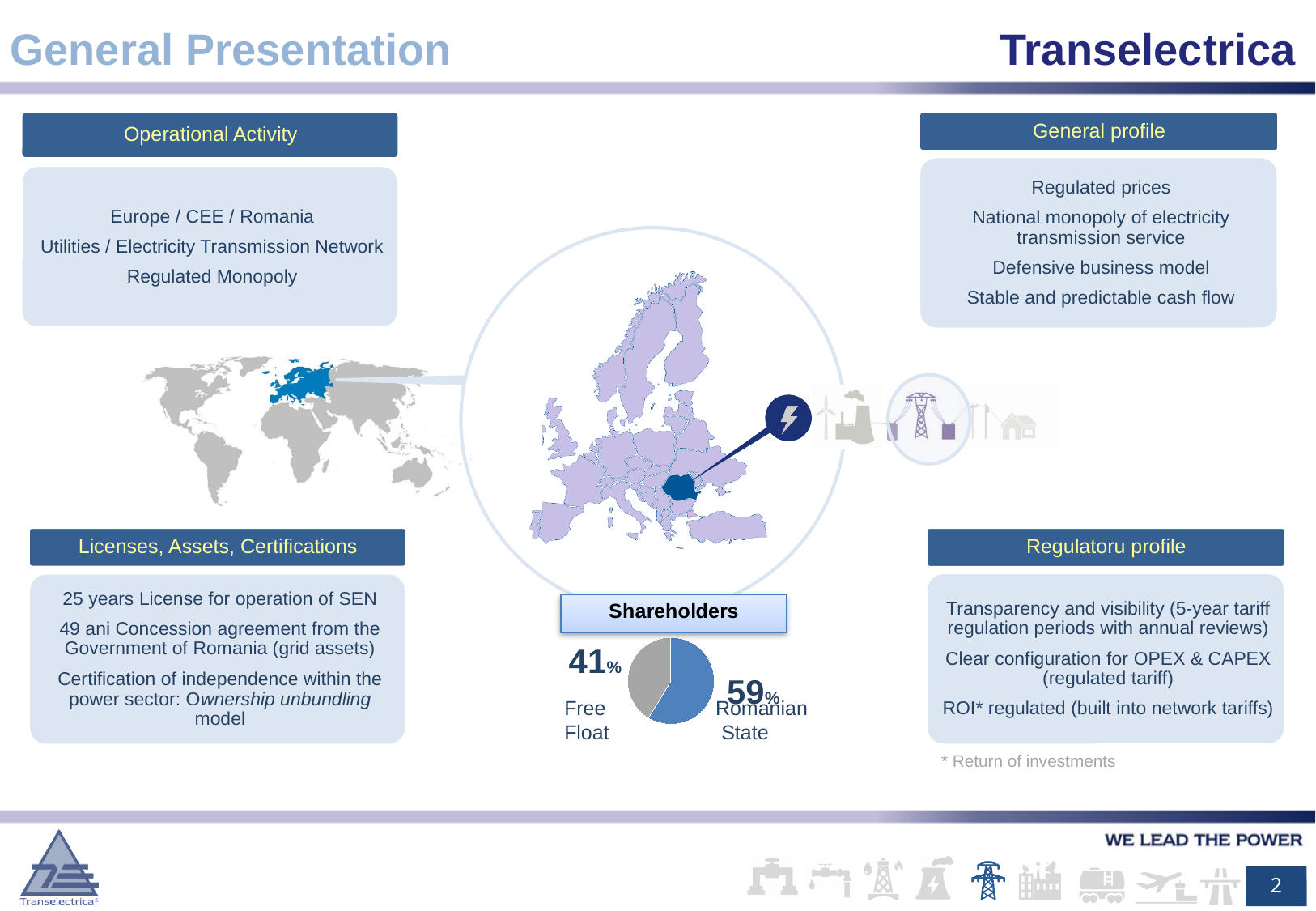
Which slice of the Shareholders pie chart is the smallest? Free Float What colour is the Romanian State slice in the Shareholders pie chart? blue Is the Free Float share in the Shareholders pie chart greater or less than 50%? less What is the total of the two slices in the Shareholders pie chart? 100% In the Shareholders pie chart, which is larger: Free Float or Romanian State? Romanian State Which slice of the Shareholders pie chart is the largest? Romanian State How many slices does the Shareholders pie chart have? 2 In the Shareholders pie chart, what is the difference between the Romanian State share and the Free Float share? 18% What kind of chart is used to show the Shareholders breakdown? pie chart What share of shareholders is Free Float in the Shareholders pie chart? 41% What share of shareholders is held by the Romanian State in the Shareholders pie chart? 59% What is the title of the chart on the slide? Shareholders